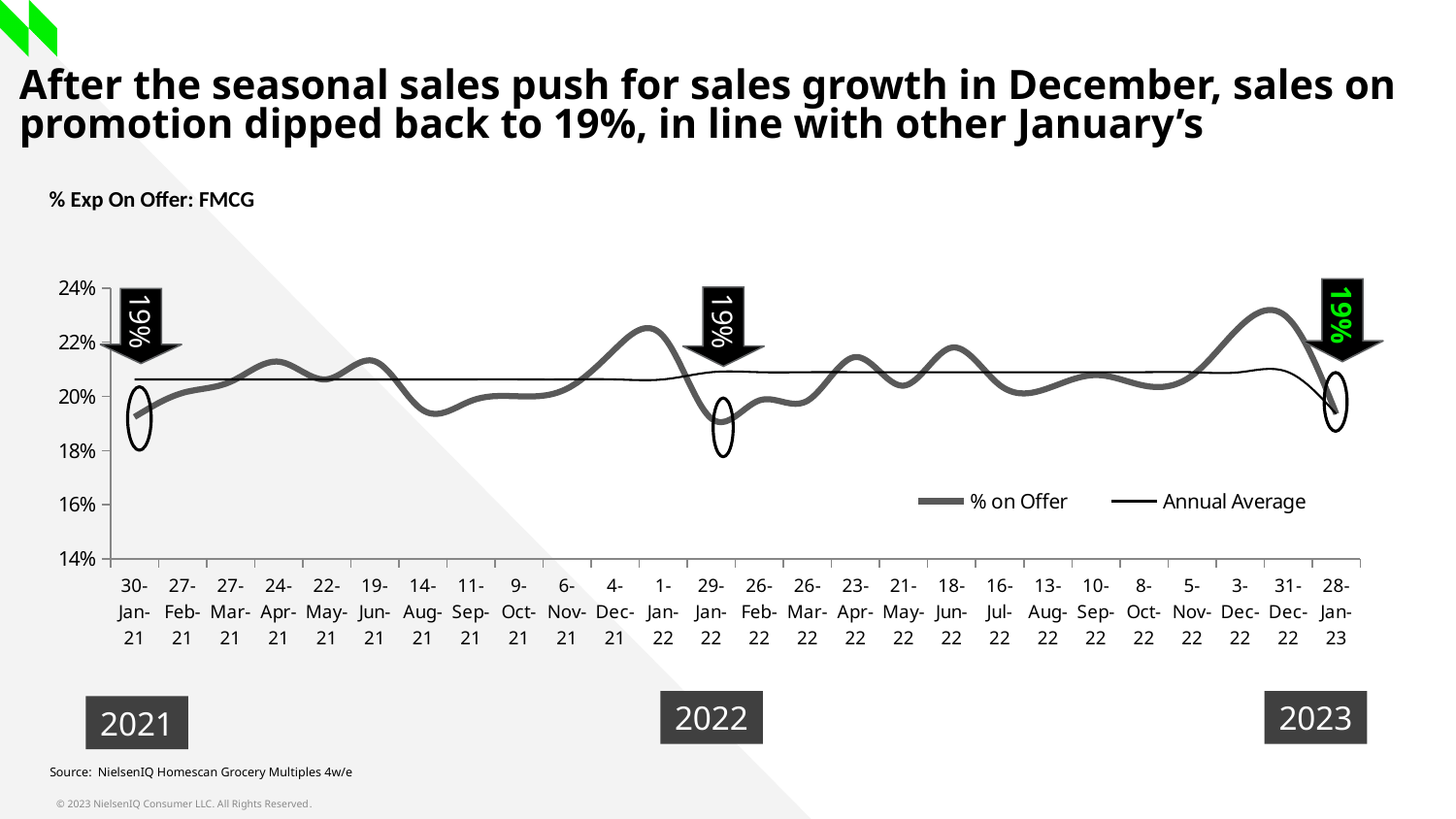
What is the % on Offer value labelled for 28-Jan-23? 19% What are the two series named in the legend? % on Offer and Annual Average Is the % on Offer value for 14-Aug-21 greater or less than 20%? less Is the % on Offer value for 31-Dec-22 greater or less than 22%? greater What is the % on Offer value labelled for 29-Jan-22? 19% What kind of chart is shown on the slide? Line chart Does the % on Offer line rise or fall between 31-Dec-22 and 28-Jan-23? Fall What is the title of the chart? % Exp On Offer: FMCG How many series does the legend list? 2 How many dates are shown on the x axis? 26 Which is larger, the % on Offer value for 31-Dec-22 or for 28-Jan-23? 31-Dec-22 What is the % on Offer value labelled for 30-Jan-21? 19%